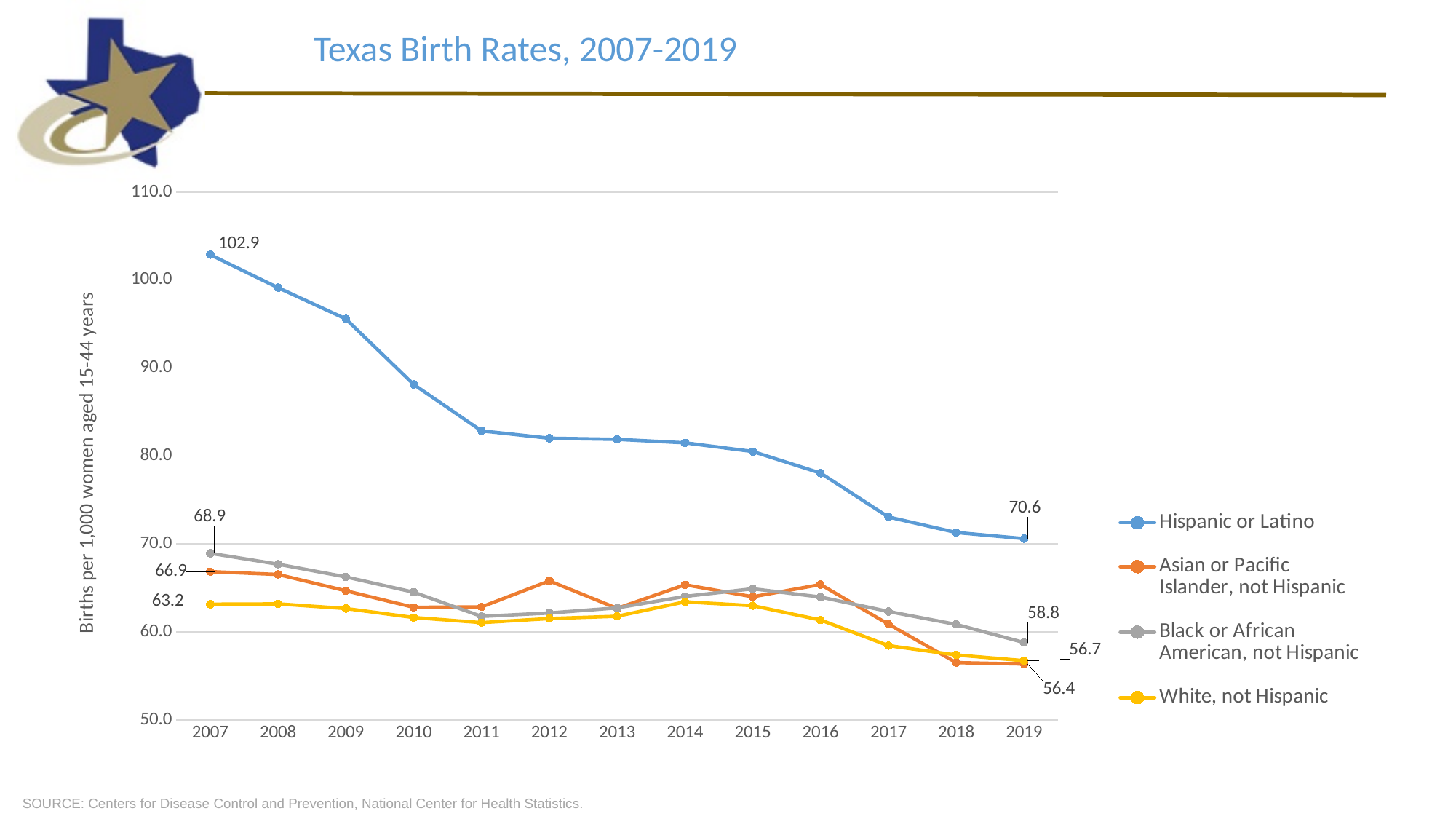
By how much did the Hispanic or Latino birth rate fall from 2007 to 2019? 32.3 What is the birth rate for Hispanic or Latino women in 2007? 102.9 Which series has the lowest value in 2019? Asian or Pacific Islander, not Hispanic How many years are plotted along the x axis? 13 What is the birth rate for Hispanic or Latino women in 2019? 70.6 What is the 2019 value for the White, not Hispanic series? 56.7 How many series does the legend list? 4 What is the 2019 value for the Asian or Pacific Islander, not Hispanic series? 56.4 Which series has the highest value in 2007? Hispanic or Latino What is the 2007 value for the Black or African American, not Hispanic series? 68.9 What kind of chart is shown on the slide? Line chart Is the Hispanic or Latino value for 2011 greater or less than 80.0? greater